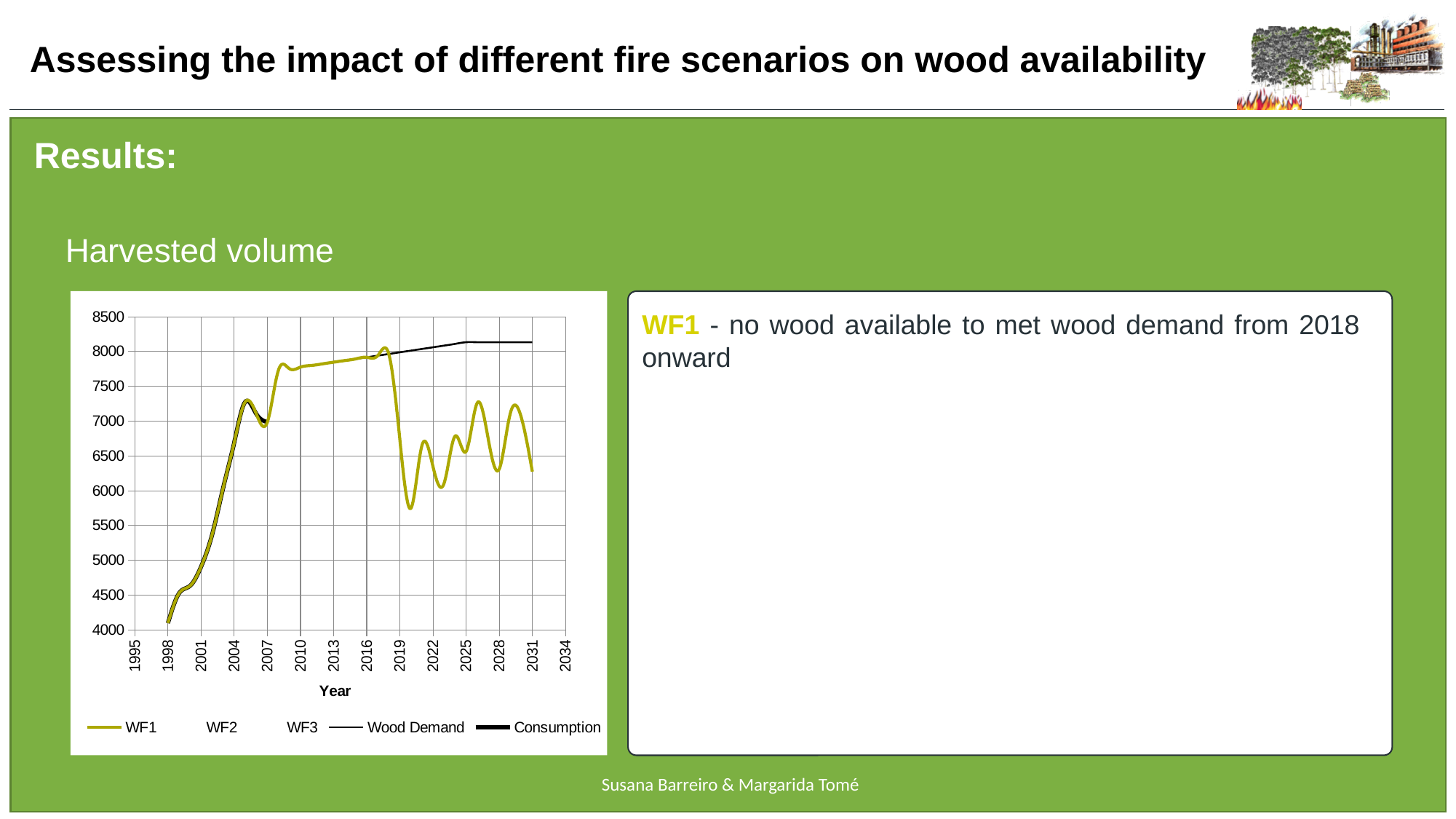
Is the value for WF1 in 1998 greater or less than 4500? less Is the value for Wood Demand in 2031 greater or less than 8000? greater In 2031, which is larger: Wood Demand or WF1? Wood Demand What is the label of the x axis of the chart? Year Which series in the chart is drawn in yellow? WF1 How many series does the chart legend list? 5 What kind of chart is shown on the slide? line chart Is the value for WF1 in 2031 greater or less than 7000? less Does the WF1 series rise or fall between 1998 and 2016? rise What is the lowest value shown on the y axis of the chart? 4000